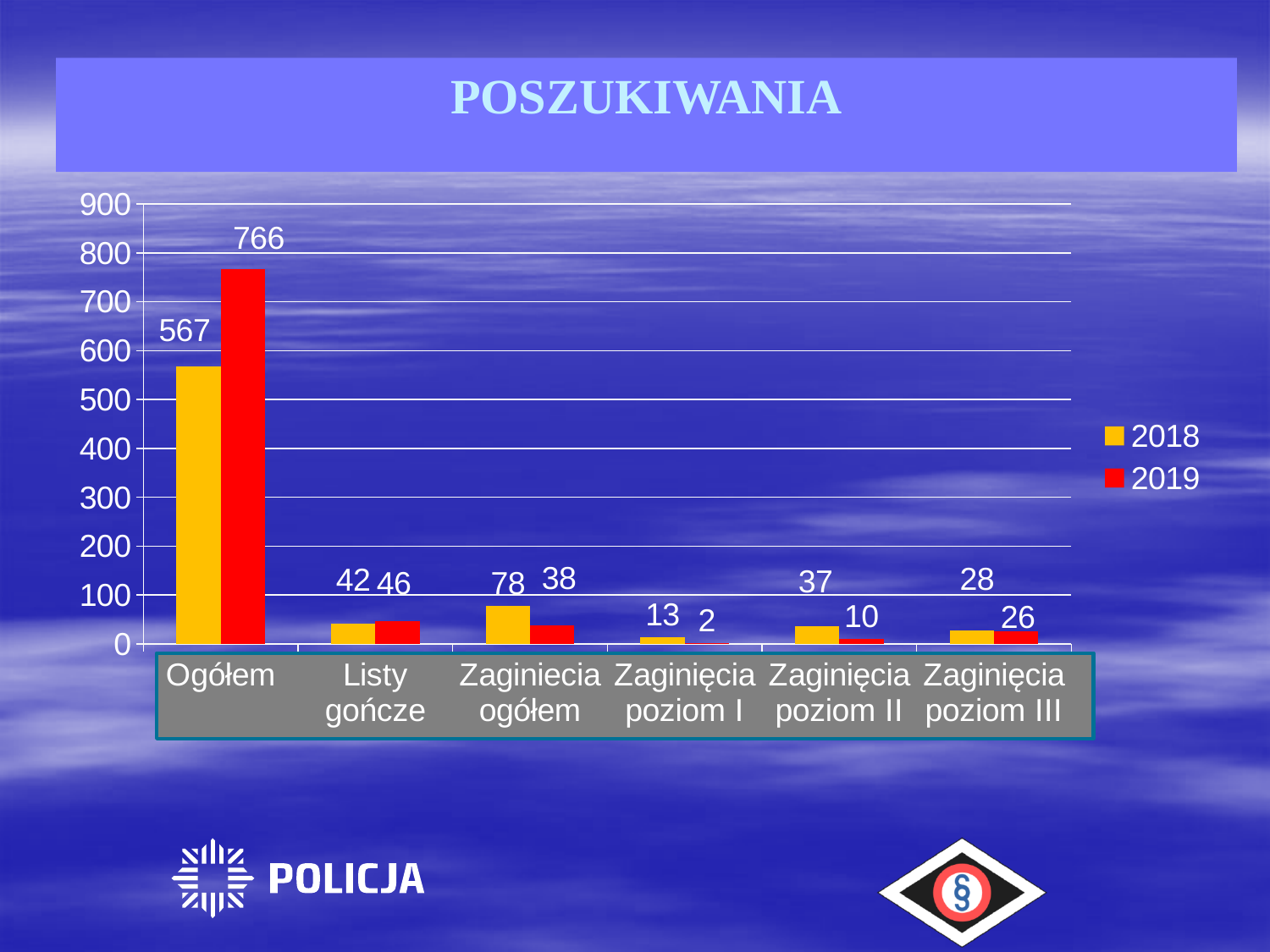
What is the value for Zaginiecia ogółem in 2018? 78 What is the difference between the 2019 and 2018 values for Ogółem? 199 Which category has the lowest value for 2019? Zaginięcia poziom I Is the value for Ogółem in 2018 greater or less than 500? greater What is the value for Zaginięcia poziom I in 2019? 2 What is the difference between the 2018 and 2019 values for Zaginięcia poziom II? 27 Which is larger for Listy gończe, the 2018 value or the 2019 value? 2019 Which category has the highest value for 2018? Ogółem How many series does the legend list? 2 How many categories are shown on the x axis? 6 What is the value for Ogółem in 2019? 766 What kind of chart is shown on the slide? bar chart